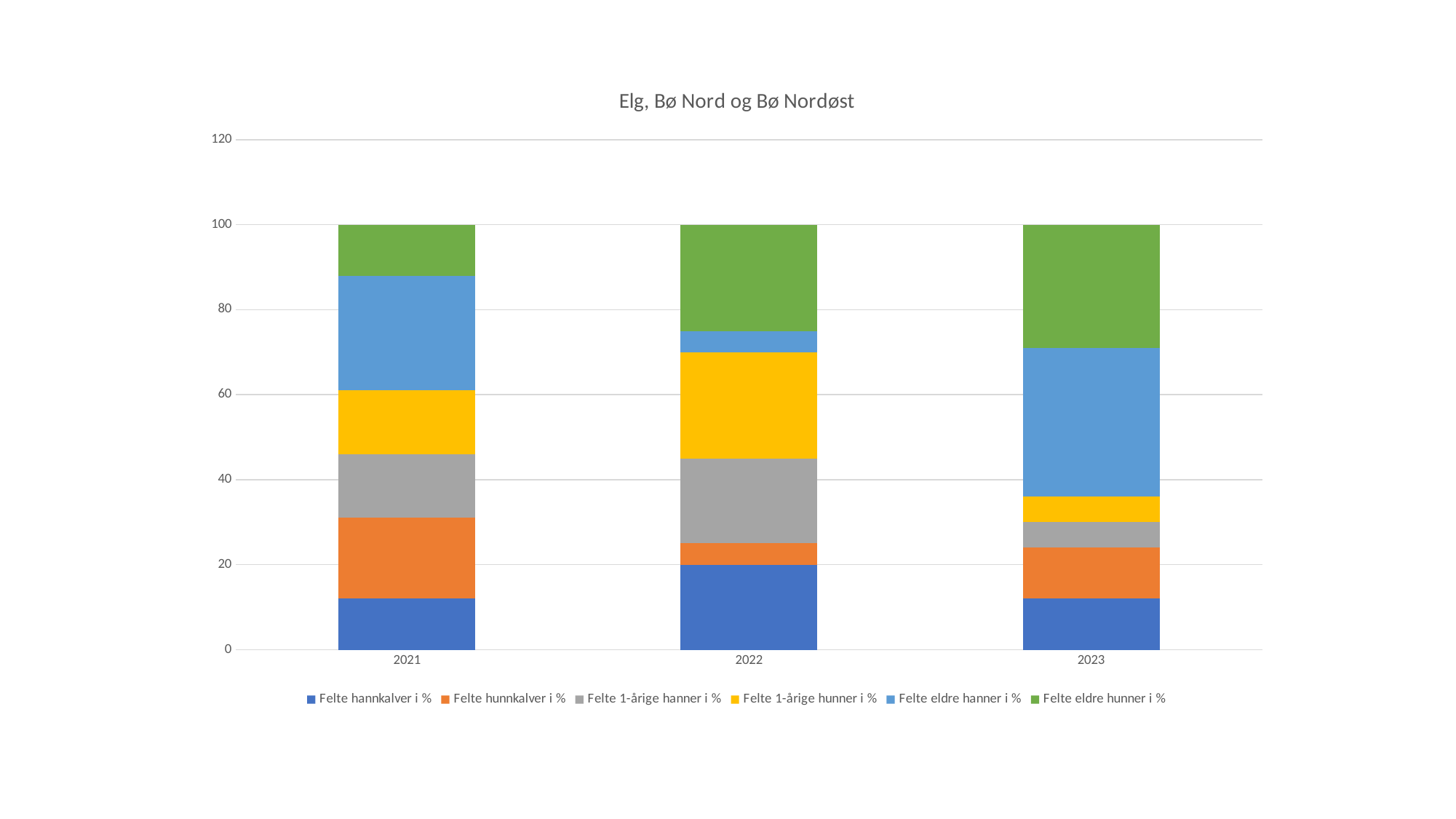
What is the total height of the stacked bar for 2021? 100 Which is larger, Felte eldre hunner i % in 2021 or in 2023? 2023 What is the value for Felte hannkalver i % in 2022? 20 Which colour represents Felte 1-årige hanner i % in the legend? Grey How many series does the legend list? 6 What kind of chart is shown on the slide? Stacked bar chart Is the value for Felte eldre hanner i % in 2023 greater or less than 20? greater Which year has the highest value for Felte 1-årige hunner i %? 2022 What is the title of the chart? Elg, Bø Nord og Bø Nordøst Is the value for Felte eldre hanner i % in 2022 greater or less than 20? less How many years are shown on the x axis? 3 Which year has the lowest value for Felte eldre hanner i %? 2022